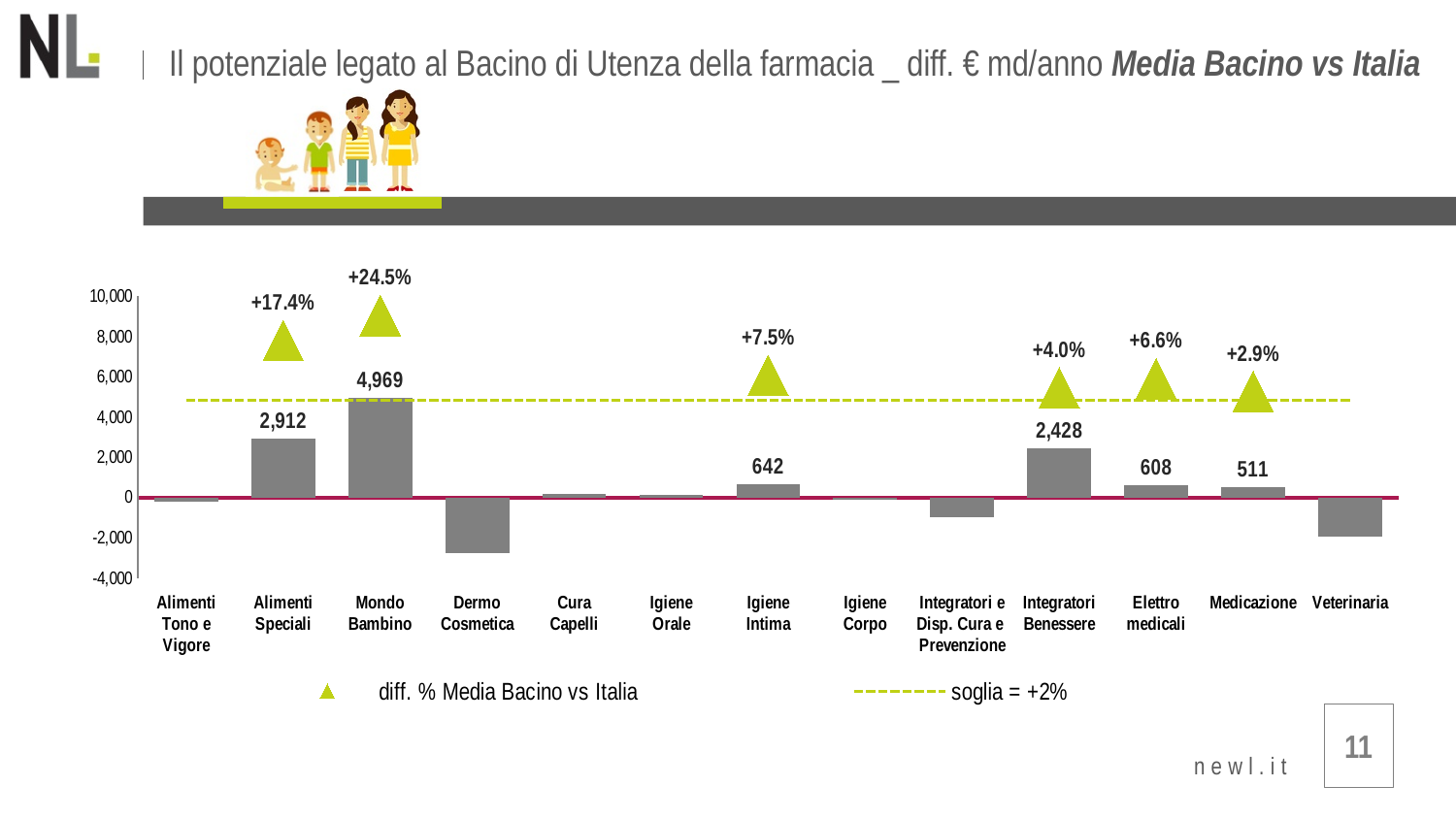
Which category has the highest bar? Mondo Bambino What is the value shown for Alimenti Speciali? 2,912 What is the value shown for Mondo Bambino? 4,969 What is the value shown for Integratori Benessere? 2,428 What is the difference between the values for Mondo Bambino and Alimenti Speciali? 2,057 What percentage difference is shown above Mondo Bambino? +24.5% What threshold value does the dashed line in the legend represent? soglia = +2% Is the value for Dermo Cosmetica greater or less than -2,000? less Which category has the lowest bar? Dermo Cosmetica What percentage difference is shown above Elettro medicali? +6.6% Which is larger, the value for Igiene Intima or the value for Medicazione? Igiene Intima How many categories are shown on the x axis? 13